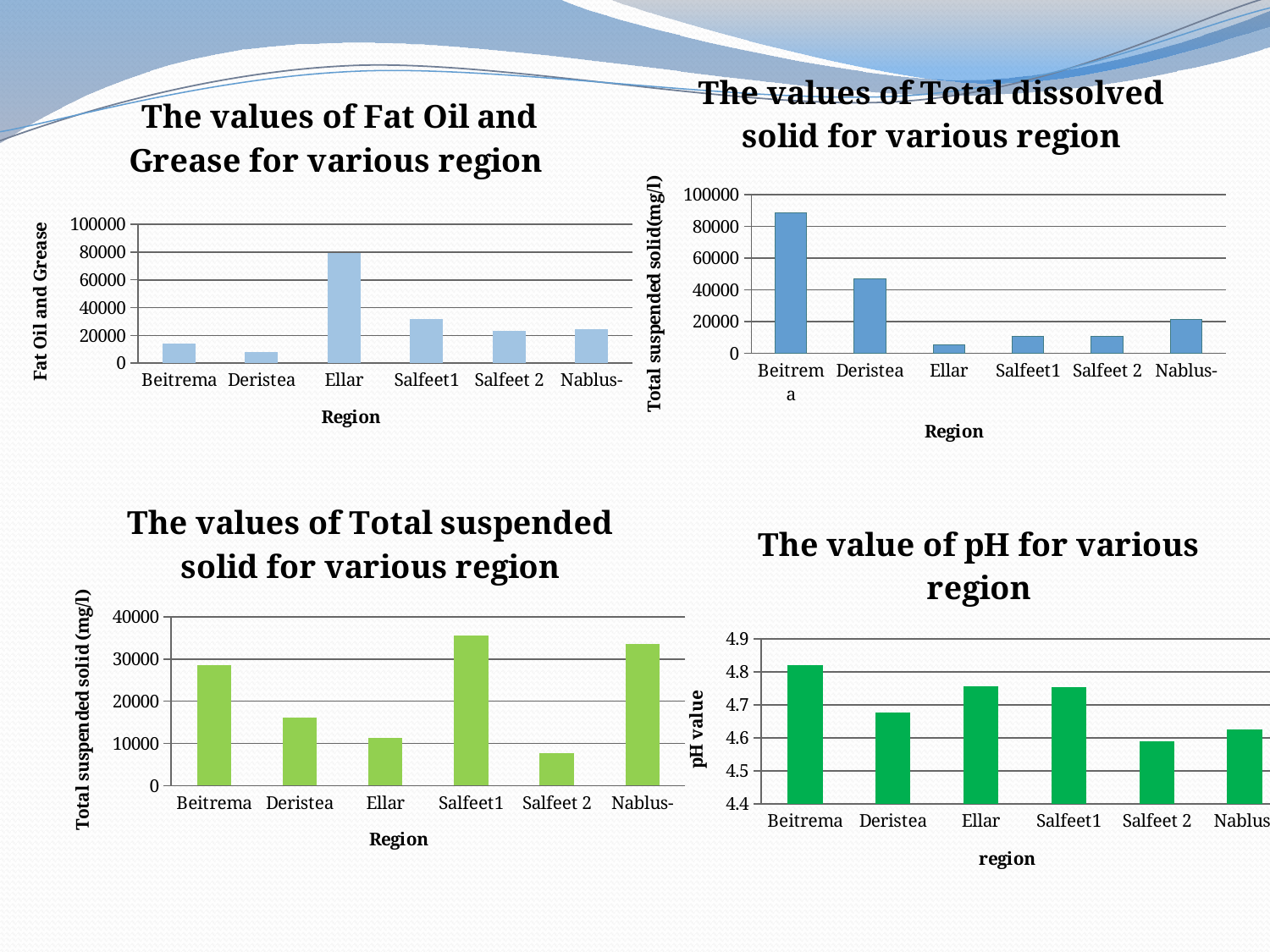
In the chart titled 'The values of Fat Oil and Grease for various region', which region has the lowest value? Deristea In the chart titled 'The values of Fat Oil and Grease for various region', which region has the highest value? Ellar In the chart titled 'The value of pH for various region', which region has the highest pH value? Beitrema In the chart titled 'The values of Total dissolved solid for various region', is the value for Deristea greater or less than 60000? less In the chart titled 'The values of Total suspended solid for various region', which is larger, the value for Beitrema or the value for Deristea? Beitrema How many regions are shown on the x axis of the chart titled 'The value of pH for various region'? 6 In the chart titled 'The values of Total dissolved solid for various region', which region has the lowest value? Ellar In the chart titled 'The values of Total suspended solid for various region', is the value for Ellar greater or less than 20000? less In the chart titled 'The values of Total dissolved solid for various region', which region has the highest value? Beitrema In the chart titled 'The value of pH for various region', which is larger, the pH value for Beitrema or the pH value for Salfeet 2? Beitrema In the chart titled 'The values of Total suspended solid for various region', which region has the lowest value? Salfeet 2 In the chart titled 'The values of Fat Oil and Grease for various region', is the value for Ellar greater or less than 60000? greater